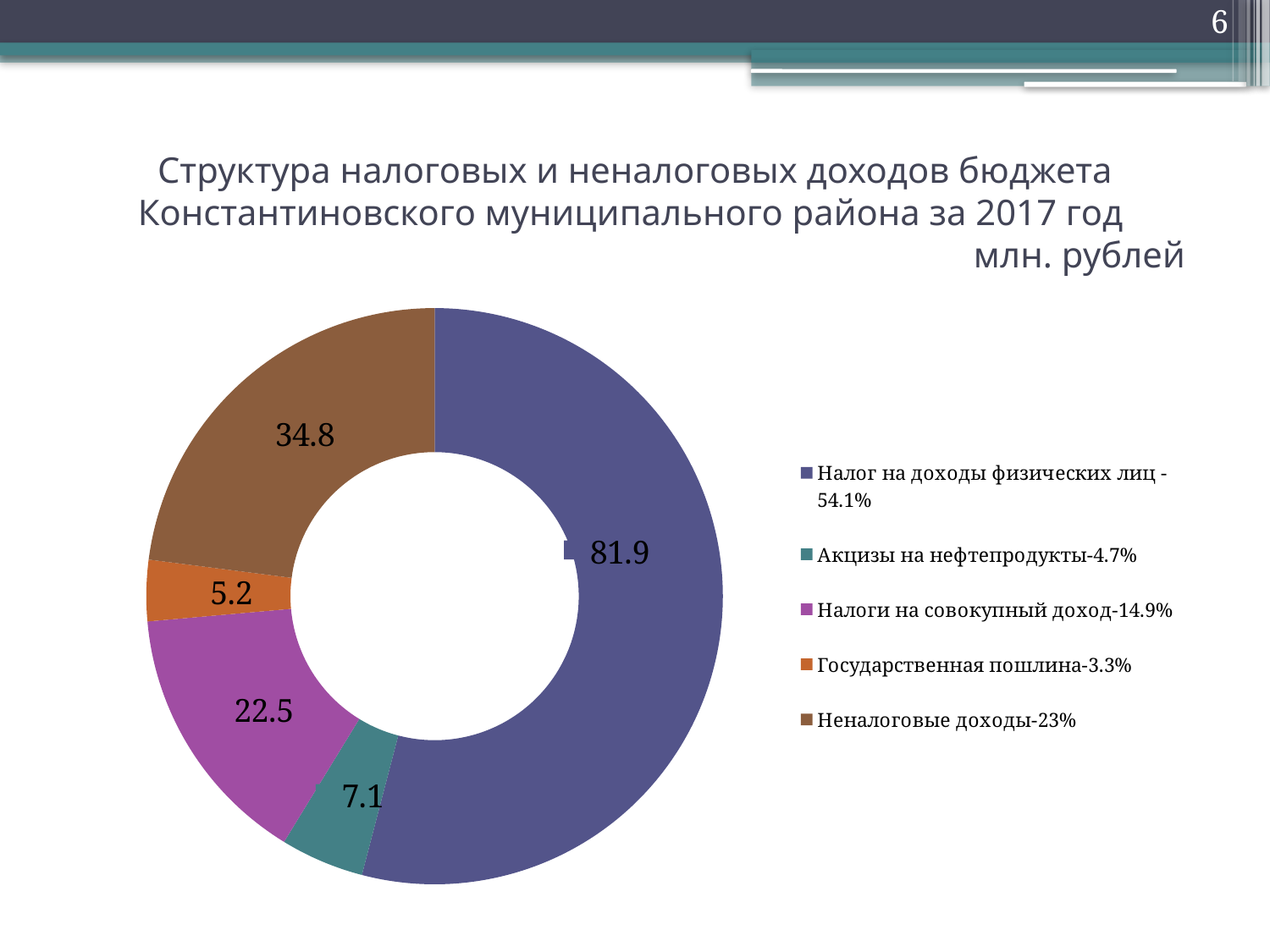
What is the value for Налоги на совокупный доход? 22.5 What is the value for Неналоговые доходы? 34.8 What is the difference between the values for Налог на доходы физических лиц and Неналоговые доходы? 47.1 What kind of chart is shown on the slide? doughnut chart Which category has the smallest value? Государственная пошлина What unit is stated for the values in the chart? млн. рублей Which category has the largest value? Налог на доходы физических лиц How many categories does the chart show? 5 Which is larger, the value for Налоги на совокупный доход or the value for Акцизы на нефтепродукты? Налоги на совокупный доход What is the value for Налог на доходы физических лиц? 81.9 What share of the total does Неналоговые доходы represent, according to the legend? 23% What is the value for Акцизы на нефтепродукты? 7.1